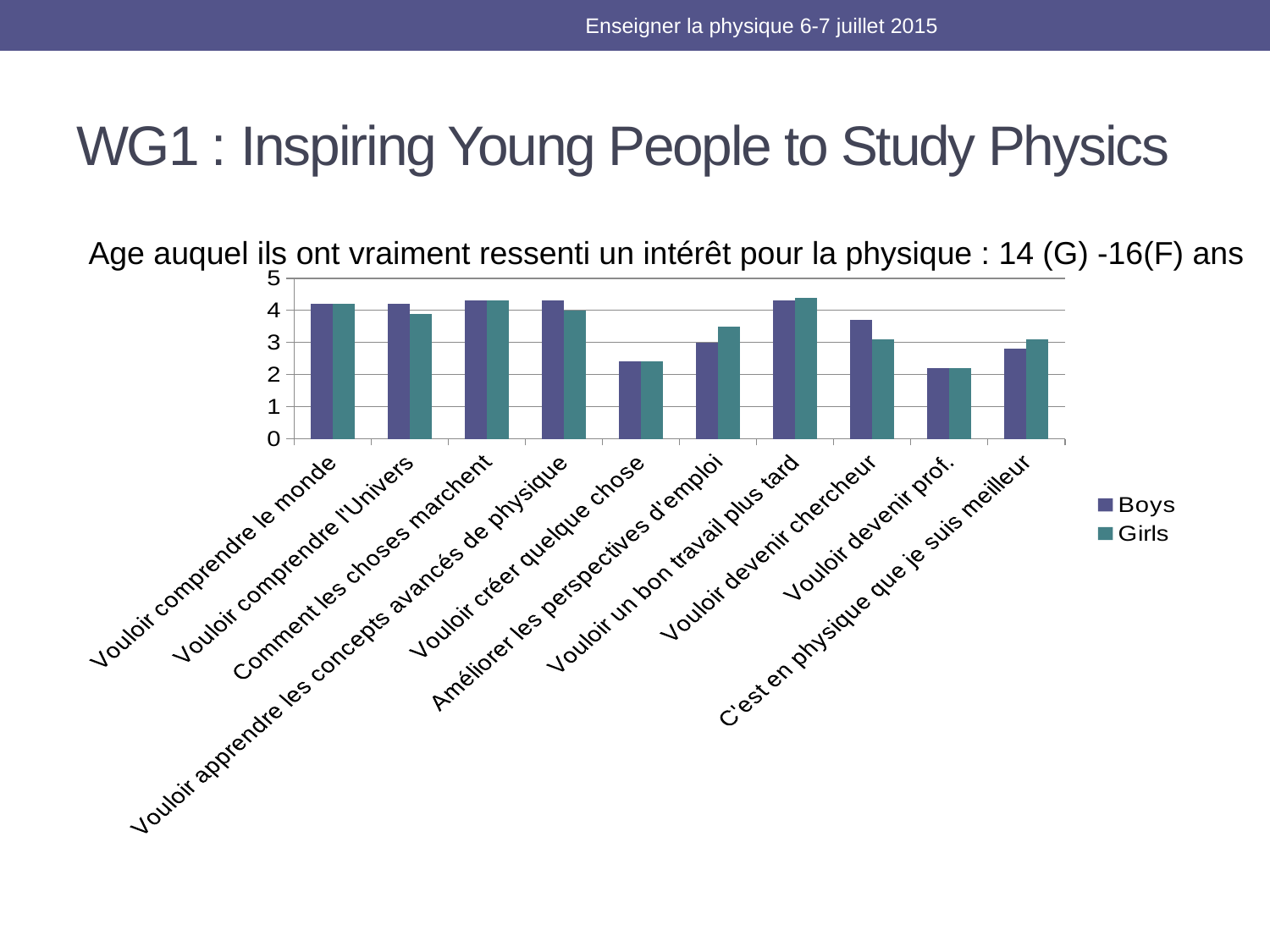
What is the highest value shown on the y axis? 5 Is the Boys value for 'Vouloir devenir prof.' greater or less than 3? less What kind of chart is shown on the slide? bar chart How many categories are shown along the x axis? 10 Is the Girls value for 'Vouloir comprendre le monde' greater or less than 4? greater How many series does the legend list? 2 For 'Améliorer les perspectives d'emploi', which is larger, the Boys value or the Girls value? Girls Is the Girls value for 'Améliorer les perspectives d'emploi' greater or less than 3? greater What are the two series named in the legend? Boys and Girls For 'Vouloir devenir chercheur', which is larger, the Boys value or the Girls value? Boys